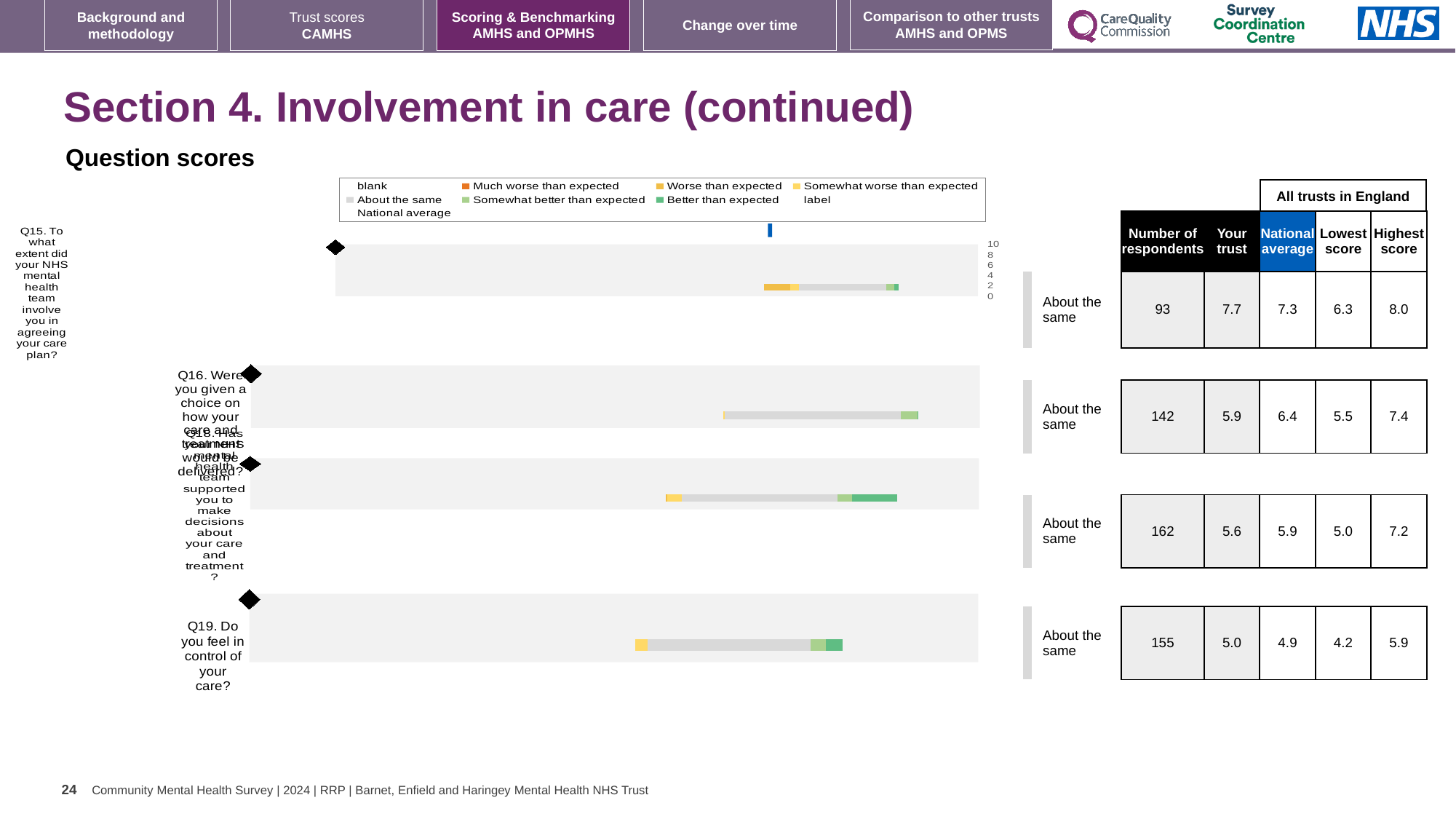
What kind of chart is used to show the question scores on this slide? bar chart How many entries does the legend of the question scores chart list? 9 In the table next to the chart, what is the highest score among all trusts in England for Q19 (feeling in control of your care)? 5.9 In the table next to the chart, what is the national average score for Q16 (choice on how care and treatment would be delivered)? 6.4 What is the difference between the national average (6.4) and the 'Your trust' score (5.9) for Q16? 0.5 What benchmark label is shown for each of the four questions on this slide? About the same In the table next to the chart, what is the 'Your trust' score for Q15 (involving you in agreeing your care plan)? 7.7 Which question has the lowest 'Your trust' score in the table next to the chart? Q19 Which question has the largest number of respondents in the table next to the chart? Q18 How many questions (categories) are plotted in the question scores chart? 4 For Q15, is the 'Your trust' score higher or lower than the national average? higher In the table next to the chart, how many respondents answered Q18 (supported to make decisions about care and treatment)? 162